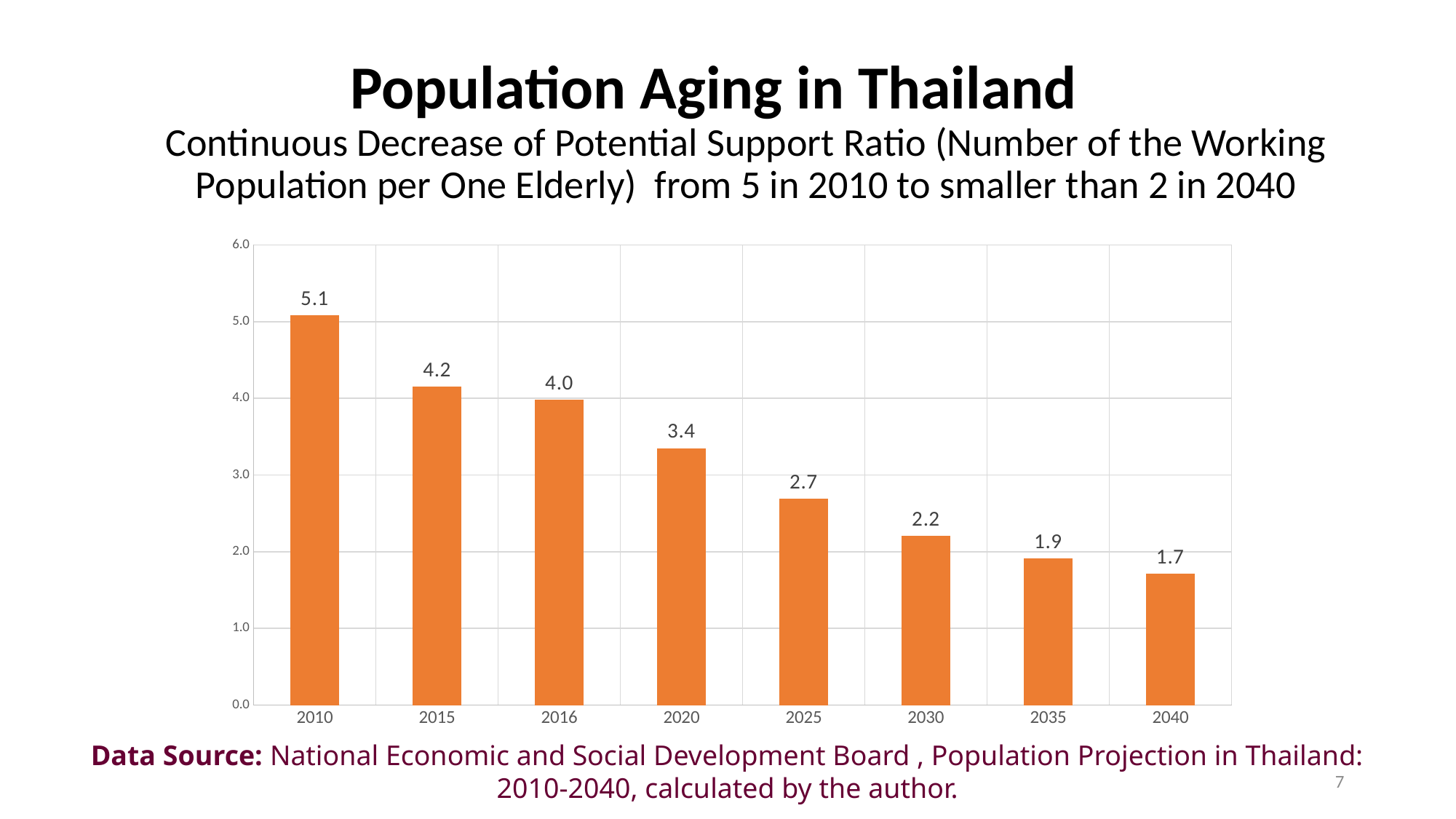
Which is larger, the value for 2016 or the value for 2030? 2016 Which year has the lowest potential support ratio? 2040 What kind of chart is shown on the slide? bar chart Do the values rise or fall from 2010 to 2040? fall Which year has the highest potential support ratio? 2010 What is the potential support ratio for 2010? 5.1 Is the value for 2035 greater or less than 2.0? less What is the value shown for 2040? 1.7 What is the difference between the values for 2010 and 2040? 3.4 How many years are shown on the x axis? 8 What is the value shown for 2025? 2.7 What is the difference between the values for 2015 and 2020? 0.8